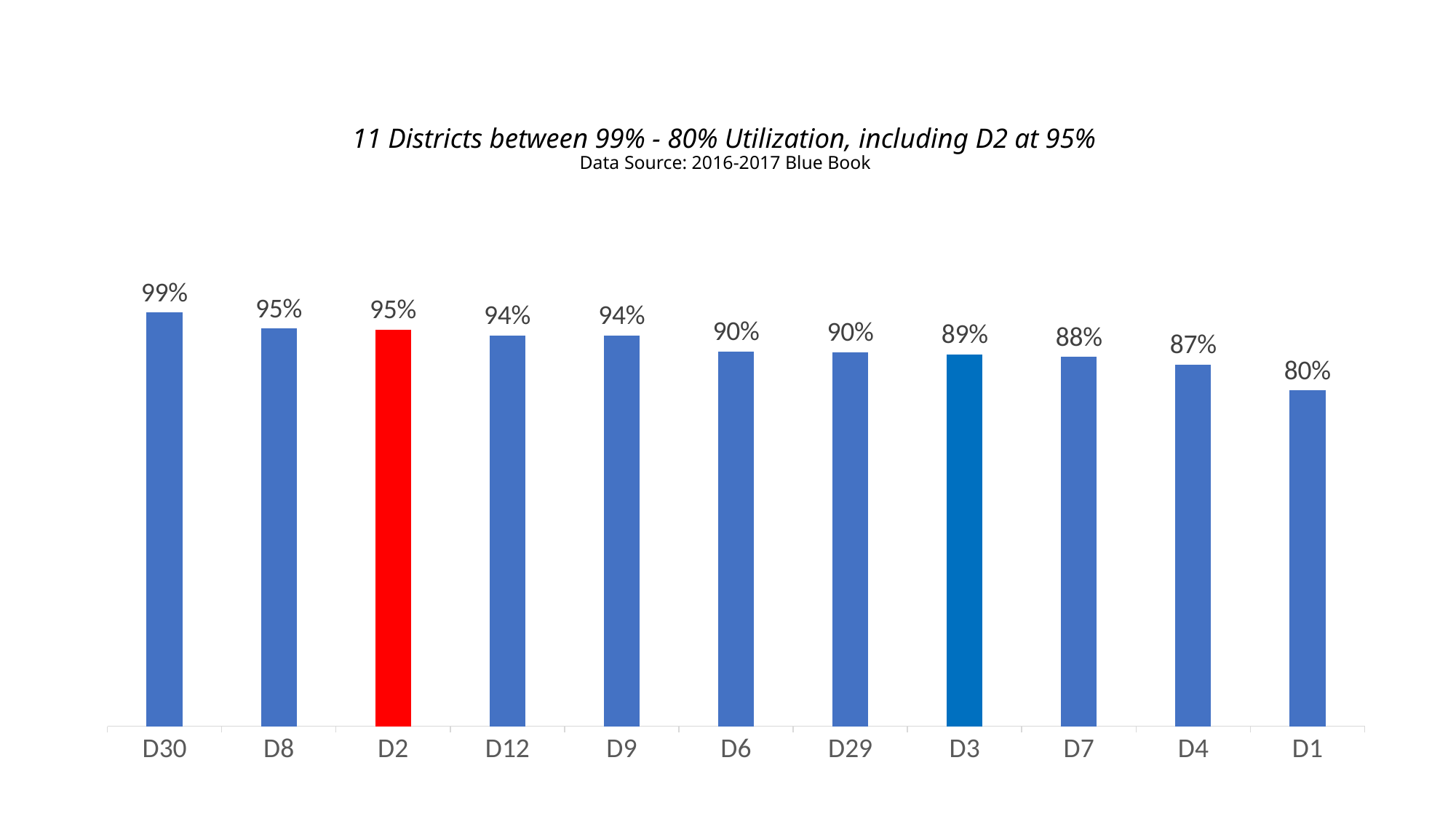
Which has a higher utilization, D12 or D7? D12 Which district has the highest utilization? D30 What is the utilization value for D29? 90% What kind of chart is shown on the slide? Bar chart What is the difference between the utilization of D2 and D3? 6% Which district's bar is coloured red? D2 Do the values rise or fall from left to right along the x axis? Fall What is the utilization value for D2? 95% Which district has the lowest utilization? D1 How many districts are shown in the chart? 11 What is the difference between the utilization of D30 and D1? 19% What is the utilization value for D4? 87%